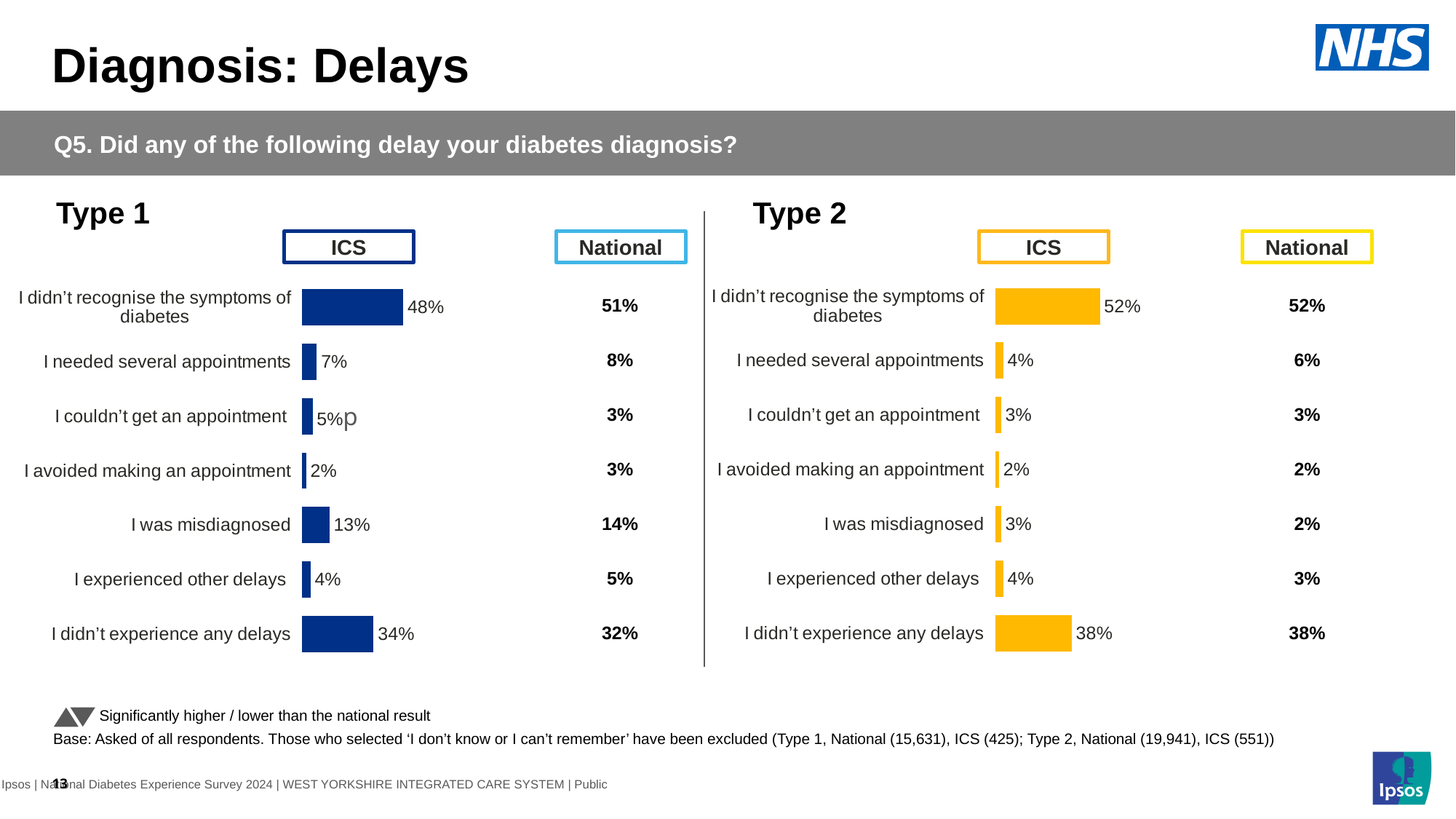
How many categories are shown in the Type 2 chart? 7 In the Type 1 chart, which category has the lowest ICS value? I avoided making an appointment In the Type 2 chart, which category has the lowest National value? I avoided making an appointment and I was misdiagnosed (both 2%) In the Type 2 chart, what is the National value for 'I needed several appointments'? 6% In the Type 1 chart, what is the National value for 'I was misdiagnosed'? 14% In the Type 2 chart, what is the ICS value for 'I didn't experience any delays'? 38% In the Type 2 chart, what is the difference between the ICS values for 'I didn't recognise the symptoms of diabetes' and 'I didn't experience any delays'? 14 percentage points In the Type 1 chart, what is the ICS value for 'I didn't recognise the symptoms of diabetes'? 48% In the Type 1 chart, which is larger: the ICS value for 'I was misdiagnosed' or the ICS value for 'I needed several appointments'? I was misdiagnosed In the Type 1 chart, what is the difference between the ICS and National values for 'I didn't experience any delays'? 2 percentage points In the Type 1 chart, which category has the highest ICS value? I didn't recognise the symptoms of diabetes What type of chart is used for the ICS values in the Type 1 section? Bar chart